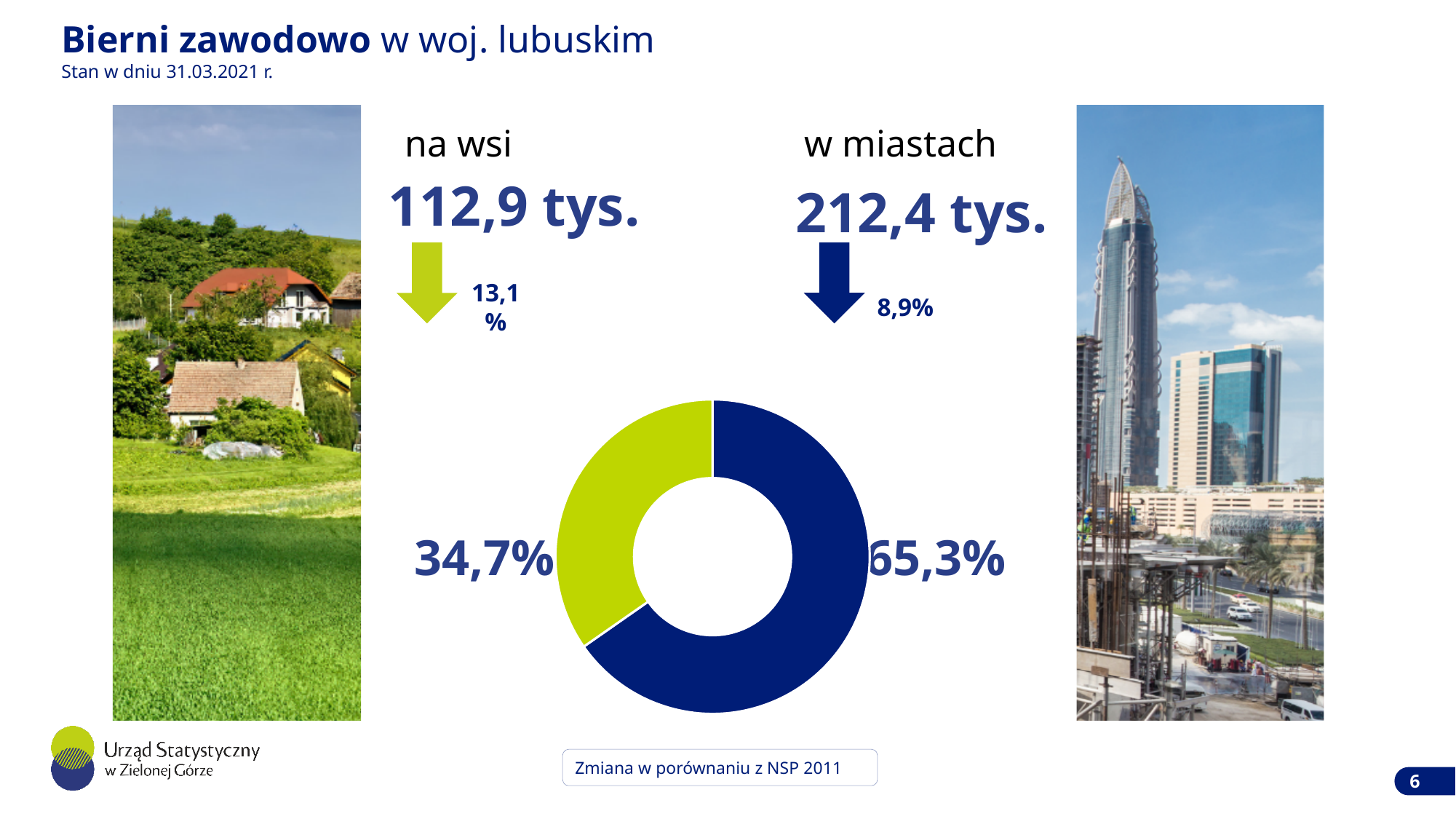
Which slice of the donut chart is larger, the green one or the navy blue one? The navy blue one What value is shown for 'w miastach' on the slide? 212,4 tys. What is the difference in percentage points between the two slices of the donut chart? 30,6 percentage points How many slices does the donut chart have? 2 What is the title of the slide containing the donut chart? Bierni zawodowo w woj. lubuskim What is the total of the two shares shown on the donut chart? 100% Which slice of the donut chart is the smallest? The green slice (34,7%) Is the share of the green slice greater or less than 50%? less What value is shown for 'na wsi' on the slide? 112,9 tys. What share does the navy blue slice of the donut chart represent? 65,3% What kind of chart is shown on the slide? Donut (pie) chart What share does the green slice of the donut chart represent? 34,7%